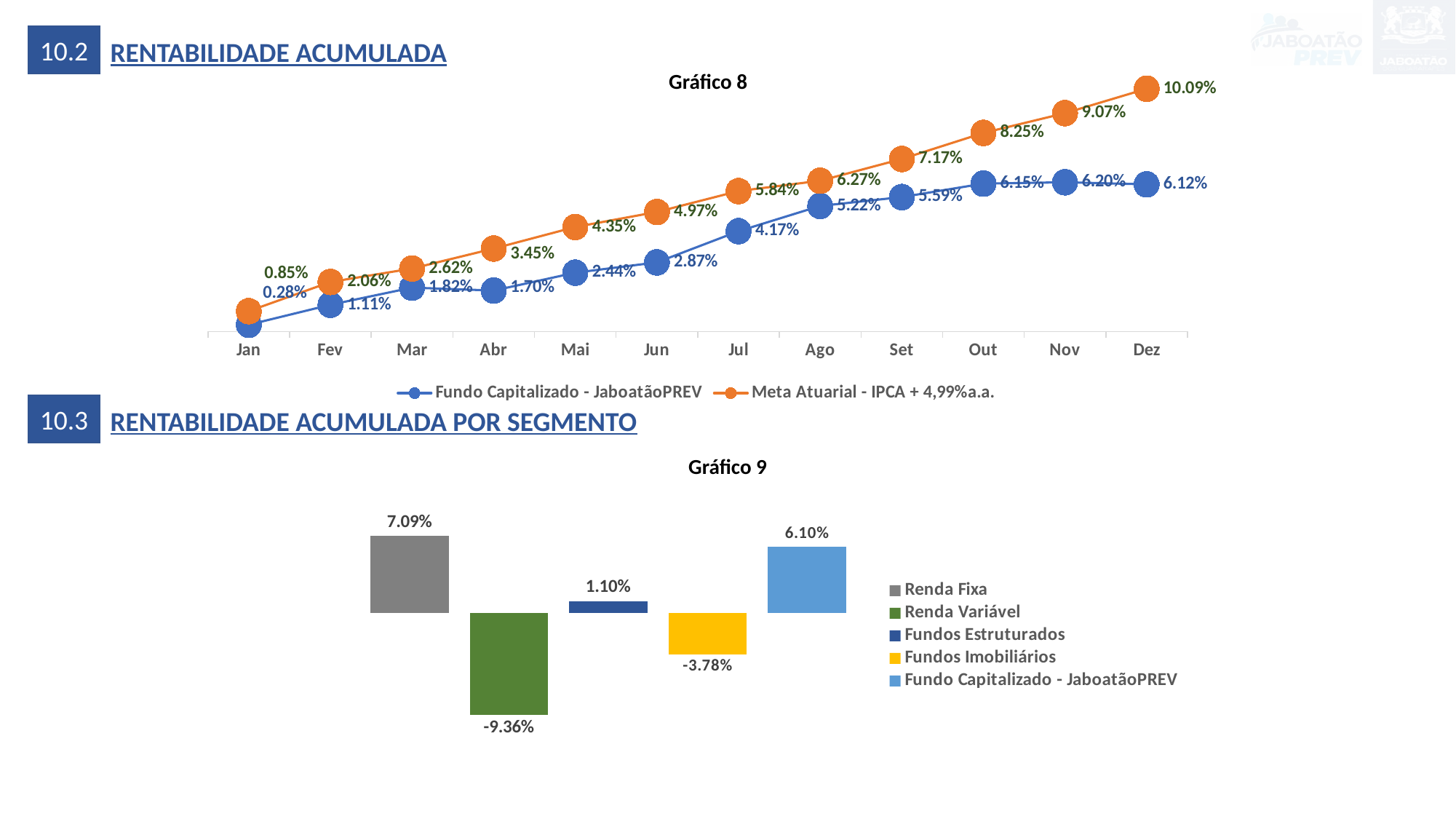
What kind of chart is Gráfico 8? line chart In Gráfico 8, which series has the higher value in Ago? Meta Atuarial - IPCA + 4,99%a.a. What kind of chart is Gráfico 9? bar chart In Gráfico 8, how many months are plotted on the x axis? 12 In Gráfico 8, how many series does the legend list? 2 In Gráfico 8, what is the value of Fundo Capitalizado - JaboatãoPREV in Jul? 4.17% In Gráfico 8, does the Meta Atuarial series rise or fall from Jan to Dez? rise In Gráfico 8, what is the difference between Meta Atuarial and Fundo Capitalizado - JaboatãoPREV in Dez? 3.97% In Gráfico 9, what is the value for Fundos Imobiliários? -3.78% In Gráfico 9, which segment has the highest value? Renda Fixa In Gráfico 8, what is the value of Meta Atuarial - IPCA + 4,99%a.a. in Dez? 10.09% In Gráfico 9, which segment has the lowest value? Renda Variável